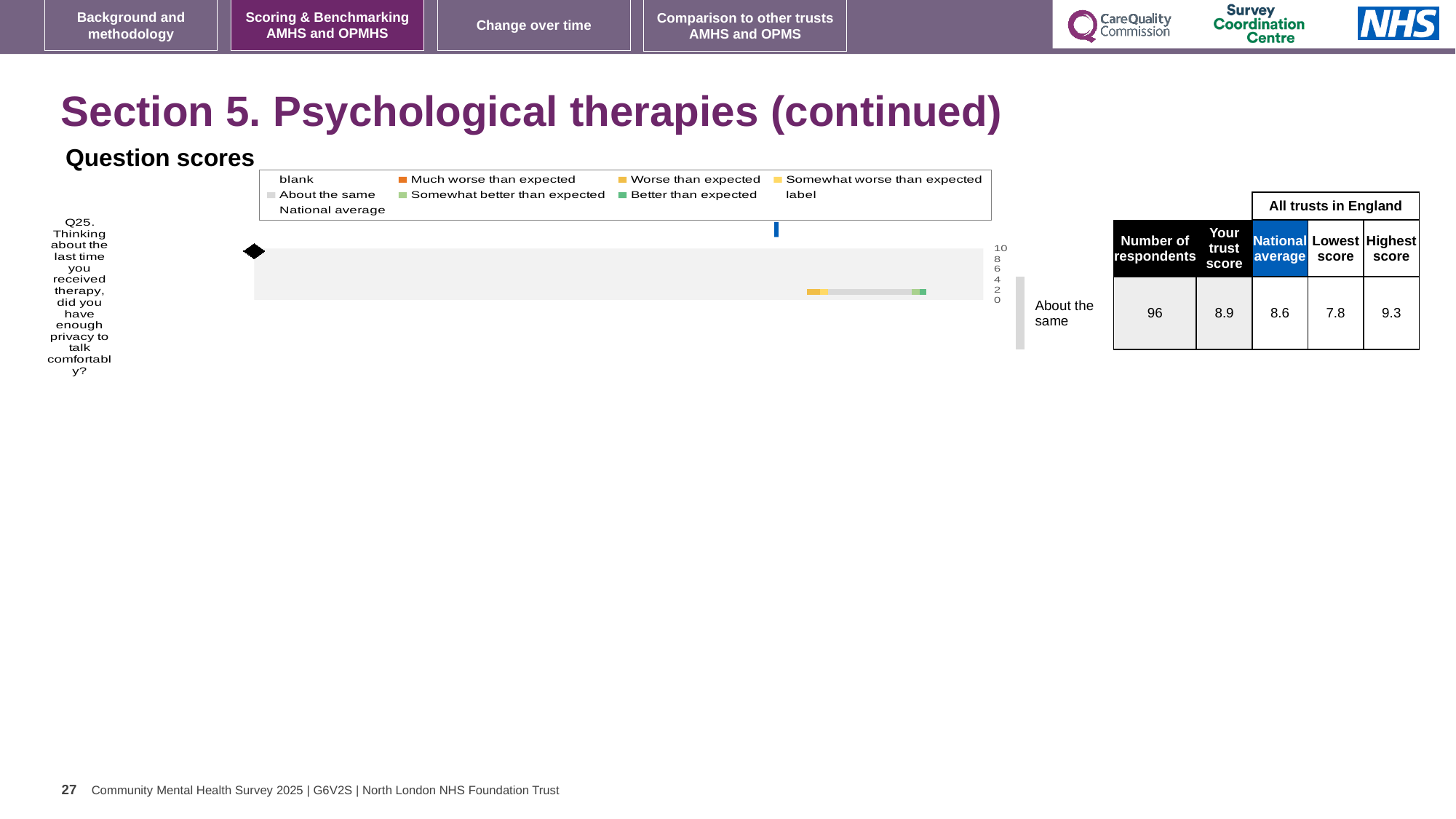
What kind of chart is shown under 'Question scores'? bar chart What is the Lowest score among all trusts in England for Q25? 7.8 For Q25, which is larger: the trust score or the National average? the trust score How many respondents are listed for Q25? 96 What is the 'Your trust score' value for Q25 in the table next to the chart? 8.9 What benchmark category label is shown beside the Q25 bar? About the same What is the highest tick value shown on the score axis of the Question scores chart? 10 What is the National average score for Q25 in the table next to the chart? 8.6 Which question number is plotted in the Question scores chart? Q25 How many survey questions are plotted in the Question scores chart? 1 What is the Highest score among all trusts in England for Q25? 9.3 What is the difference between the Highest score and the Lowest score for Q25? 1.5